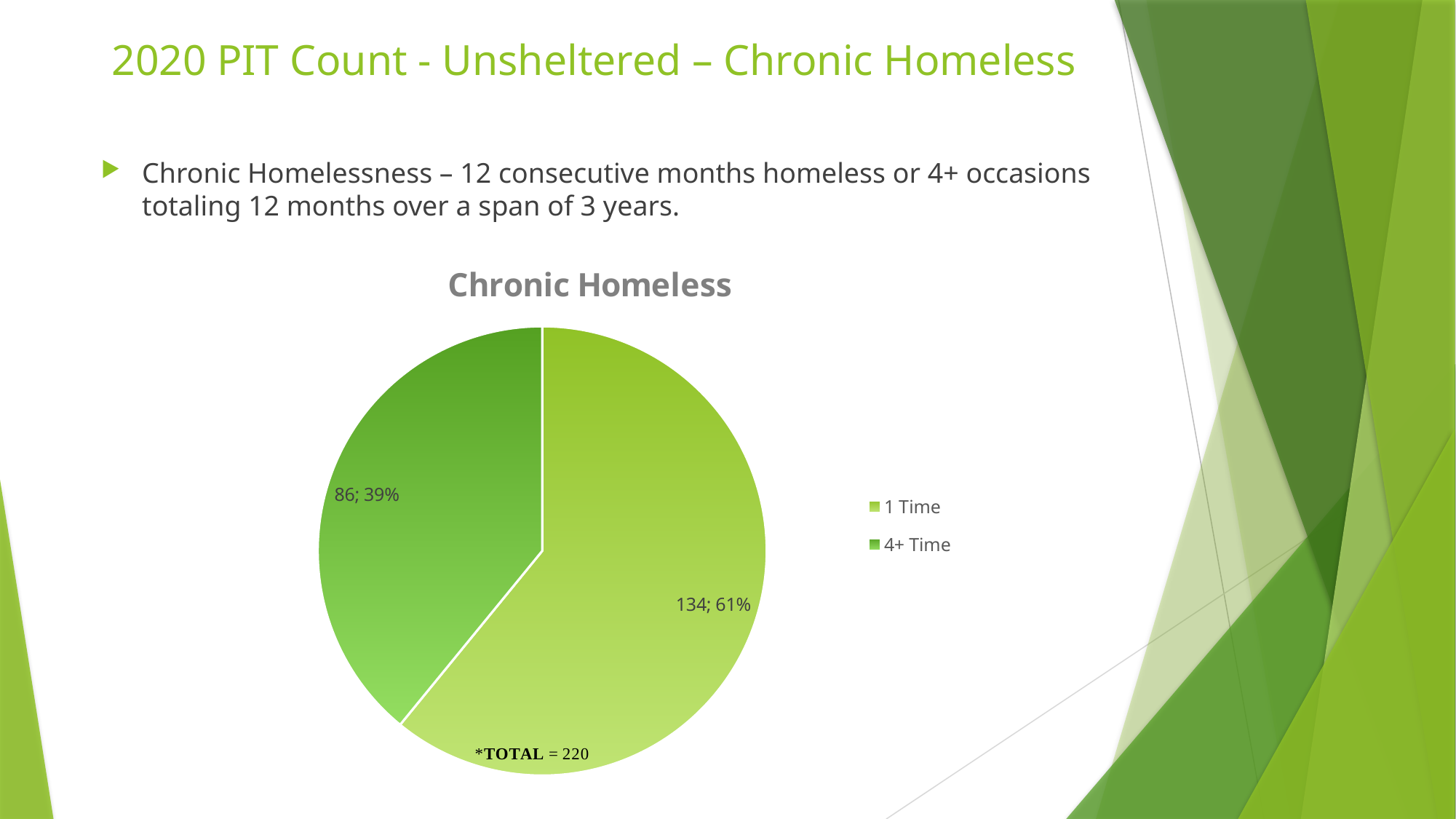
What kind of chart is shown on the slide? pie chart Which slice is the largest? 1 Time What is the total shown for the chart? 220 How many entries does the legend list? 2 How many slices does the pie chart have? 2 What is the difference between the 1 Time and 4+ Time values? 48 What share of the pie does the 1 Time slice represent? 61% What is the value for the 4+ Time slice? 86 What is the value for the 1 Time slice? 134 What share of the pie does the 4+ Time slice represent? 39% What is the title of the chart? Chronic Homeless Which slice is the smallest? 4+ Time